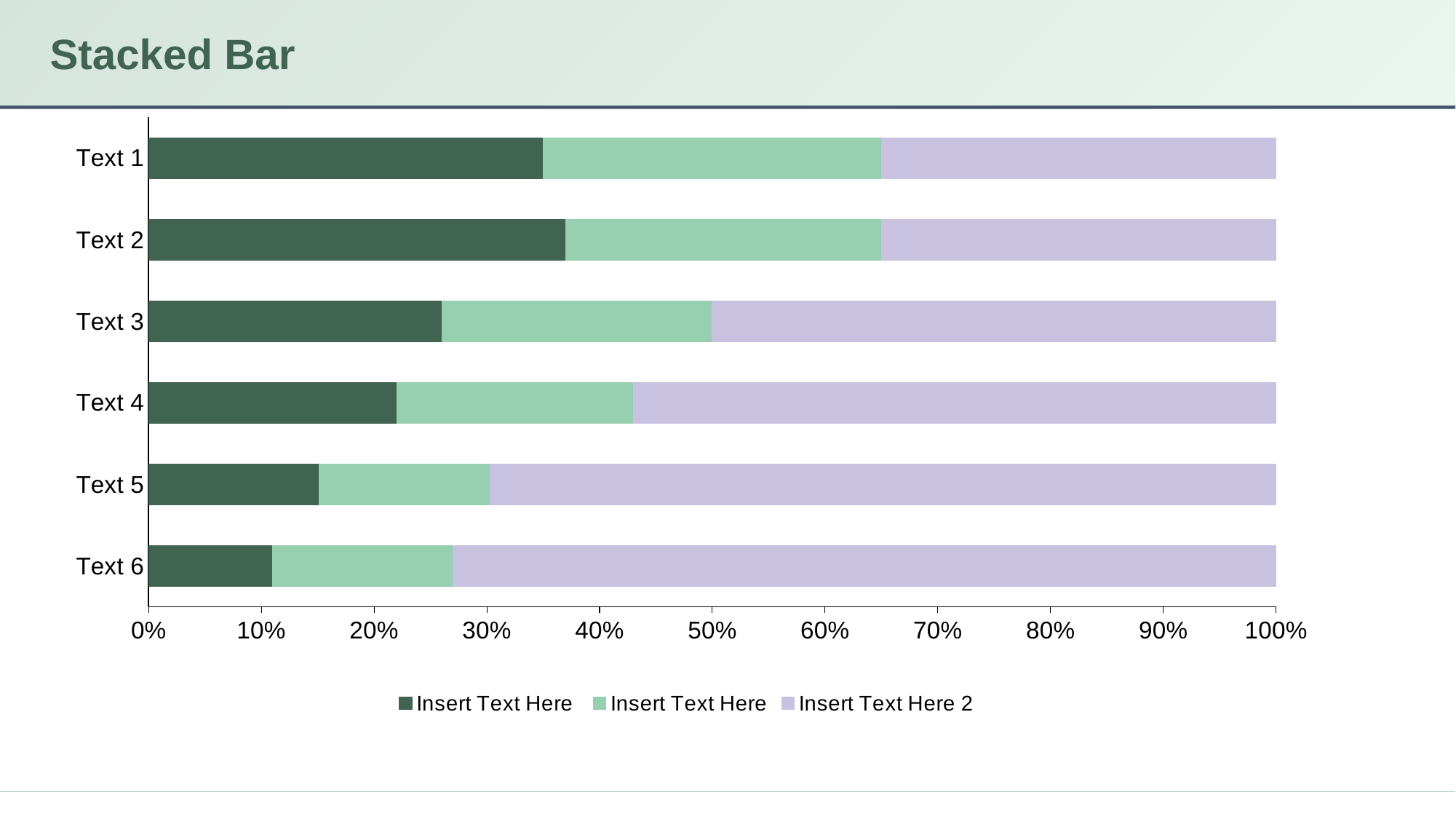
What is the label of the third legend entry? Insert Text Here 2 What kind of chart is shown on the slide? Stacked bar chart Is the dark green segment for Text 5 greater or less than 20%? less Which category has the smallest dark green segment? Text 6 How many series does the legend list? 3 What is the title of the slide? Stacked Bar Which is larger, the dark green segment for Text 3 or the dark green segment for Text 5? Text 3 How many categories are plotted on the vertical axis? 6 Which is larger, the light purple segment for Text 1 or the light purple segment for Text 6? Text 6 Is the dark green segment for Text 1 greater or less than 30%? greater Is the dark green segment for Text 6 greater or less than 20%? less What total does the stacked bar for Text 3 reach on the horizontal axis? 100%